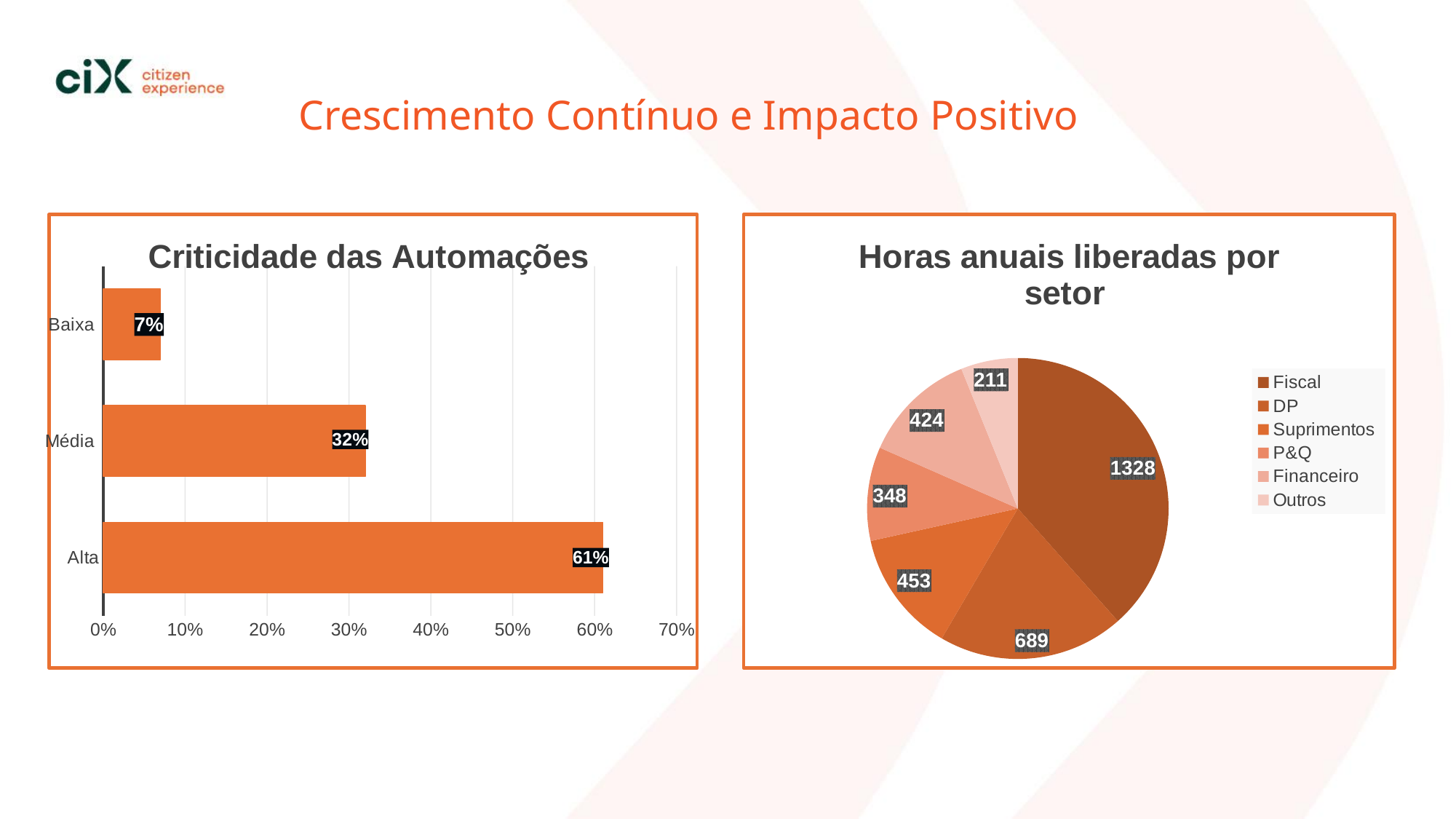
In the 'Horas anuais liberadas por setor' chart, what is the difference between Financeiro and Outros? 213 In the 'Horas anuais liberadas por setor' chart, how many hours are shown for Fiscal? 1328 What kind of chart is 'Criticidade das Automações'? Bar chart In the 'Horas anuais liberadas por setor' chart, which sector has the smallest slice? Outros In the 'Criticidade das Automações' chart, what is the value for Baixa? 7% In the 'Criticidade das Automações' chart, which category has the highest value? Alta In the 'Criticidade das Automações' chart, what is the value for Alta? 61% In the 'Criticidade das Automações' chart, how many categories are shown? 3 How many sectors does the legend of the 'Horas anuais liberadas por setor' chart list? 6 In the 'Horas anuais liberadas por setor' chart, how many hours are shown for P&Q? 348 In the 'Horas anuais liberadas por setor' chart, which is larger, DP or Suprimentos? DP In the 'Criticidade das Automações' chart, what is the difference between Alta and Média? 29%